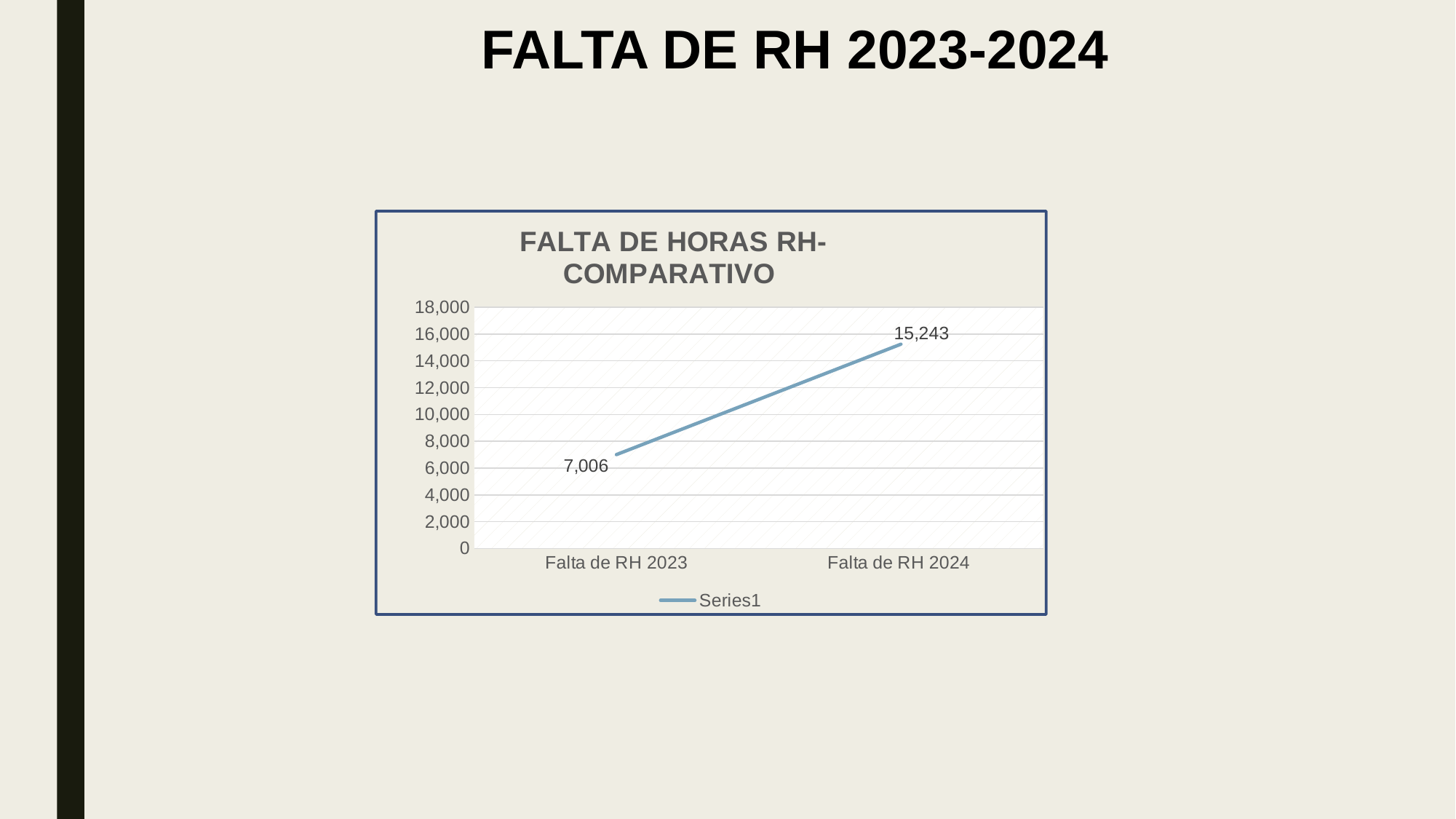
What kind of chart is shown? line chart Is the value for Falta de RH 2023 greater or less than 8,000? less Which is larger, the value for Falta de RH 2023 or Falta de RH 2024? Falta de RH 2024 Which category has the highest value? Falta de RH 2024 Do the values rise or fall from Falta de RH 2023 to Falta de RH 2024? rise Is the value for Falta de RH 2024 greater or less than 14,000? greater What is the difference between the values for Falta de RH 2024 and Falta de RH 2023? 8,237 How many categories are shown on the x axis? 2 How many series does the legend list? 1 What is the value for Falta de RH 2023? 7,006 What is the value for Falta de RH 2024? 15,243 Which category has the lowest value? Falta de RH 2023